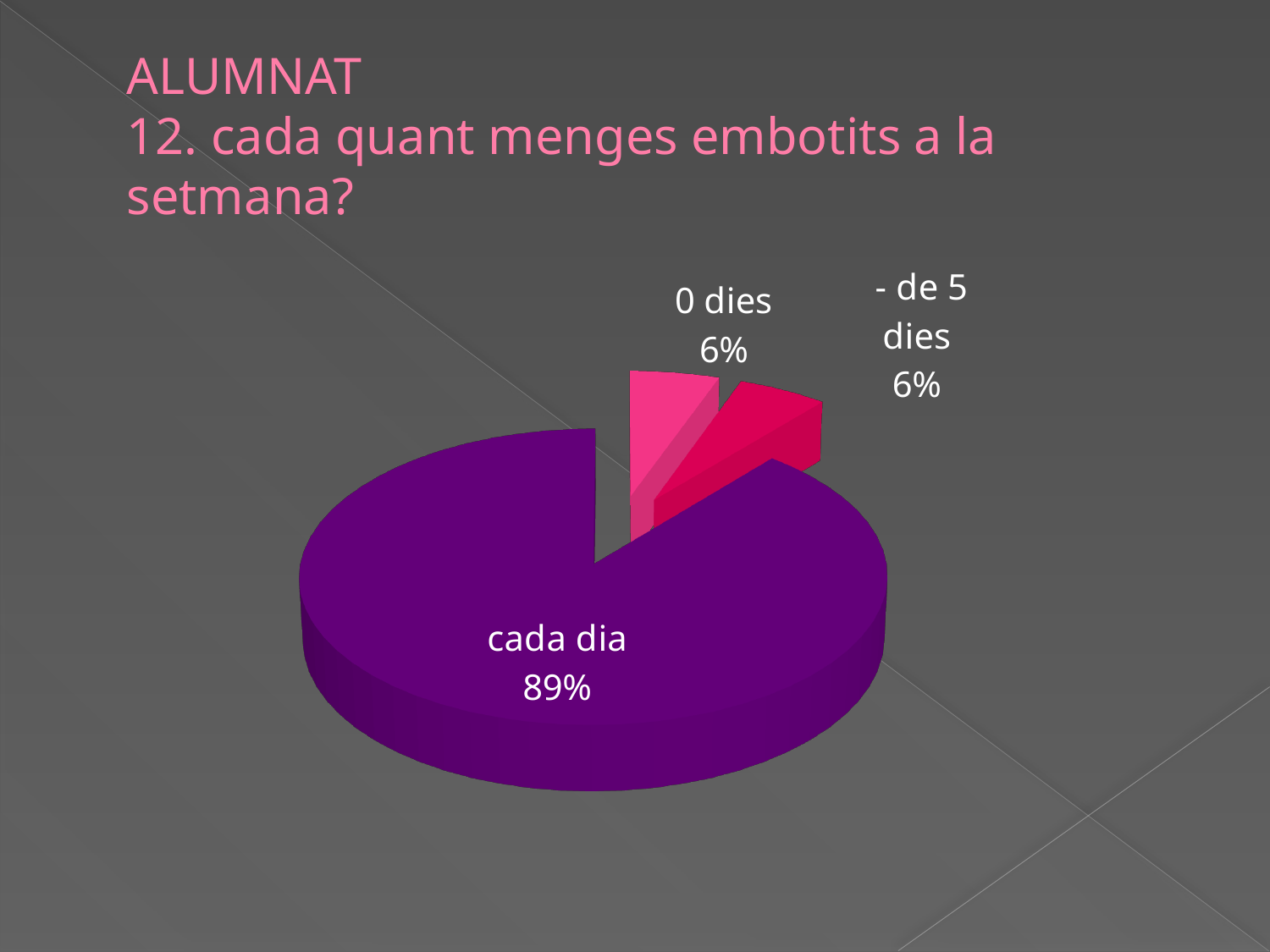
What is the combined share of "0 dies" and "- de 5 dies"? 12% What share of the pie does "0 dies" represent? 6% Which category has the largest slice of the pie? cada dia What is the difference in percentage points between "cada dia" and "0 dies"? 83 What colour is the "cada dia" slice? purple What kind of chart is shown on the slide? pie chart Is the share for "cada dia" greater or less than 50%? greater Which is larger, the share for "cada dia" or the share for "- de 5 dies"? cada dia What question does the slide title ask about the chart? 12. cada quant menges embotits a la setmana? What share of the pie does "- de 5 dies" represent? 6% What share of the pie does "cada dia" represent? 89% How many slices does the pie chart have? 3